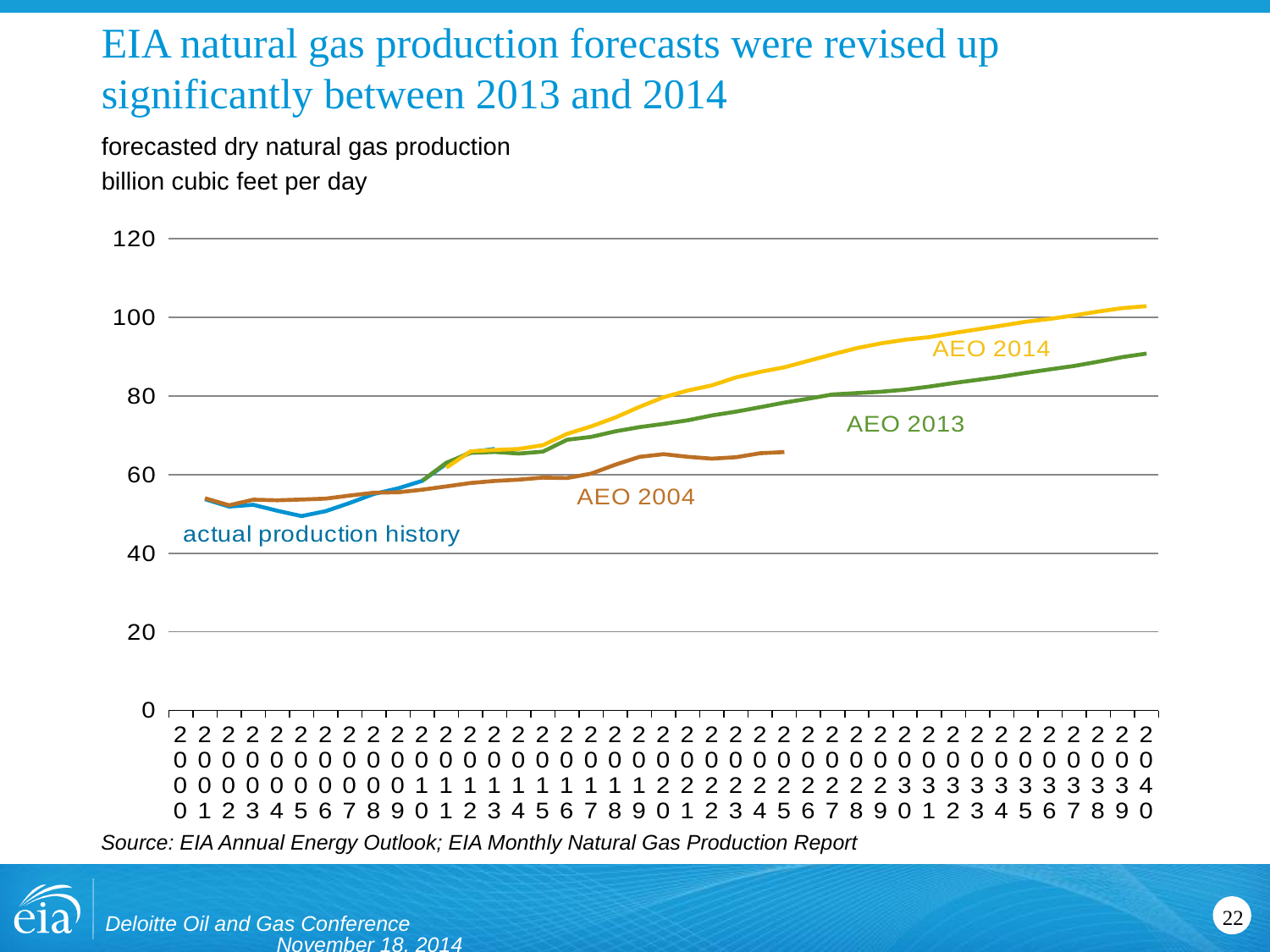
How many series are plotted on the chart? 4 Which forecast series is higher in 2040, AEO 2014 or AEO 2013? AEO 2014 What unit is the y axis measured in, according to the chart subtitle? billion cubic feet per day Is the value for AEO 2014 in 2040 greater or less than 80? greater Is the value for actual production history in 2005 greater or less than 60? less Is the value for AEO 2013 in 2040 greater or less than 100? less What is the highest value shown on the y axis? 120 Does the AEO 2014 series rise or fall from 2013 to 2040? rise What kind of chart is shown on the slide? line chart Which series reaches the highest value at the right end of the chart (2040)? AEO 2014 Which series ends earliest along the x axis? actual production history